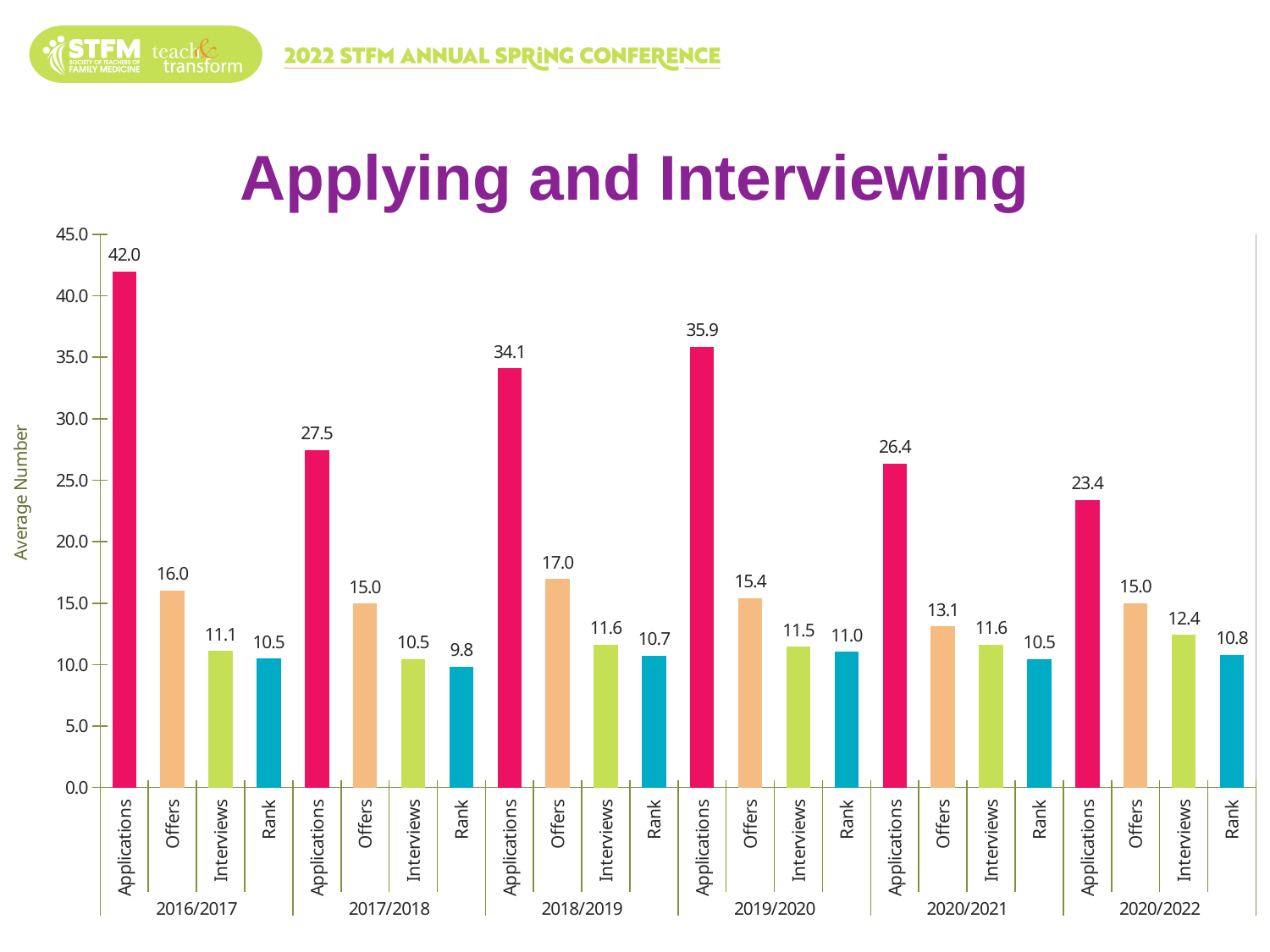
Is the Applications value for 2020/2021 greater or less than 25.0? greater Which is larger, the Applications value for 2018/2019 or for 2019/2020? 2019/2020 What is the Rank value for 2017/2018? 9.8 What is the average number of Offers for 2018/2019? 17.0 Which year group has the lowest Applications value? 2020/2022 What is the title of the chart? Applying and Interviewing What is the average number of Applications for 2016/2017? 42.0 How many year groups are shown on the x axis? 6 Which year group has the highest Applications value? 2016/2017 What is the average number of Interviews for 2020/2022? 12.4 What kind of chart is shown on the slide? bar chart What is the difference between the Applications values for 2016/2017 and 2017/2018? 14.5